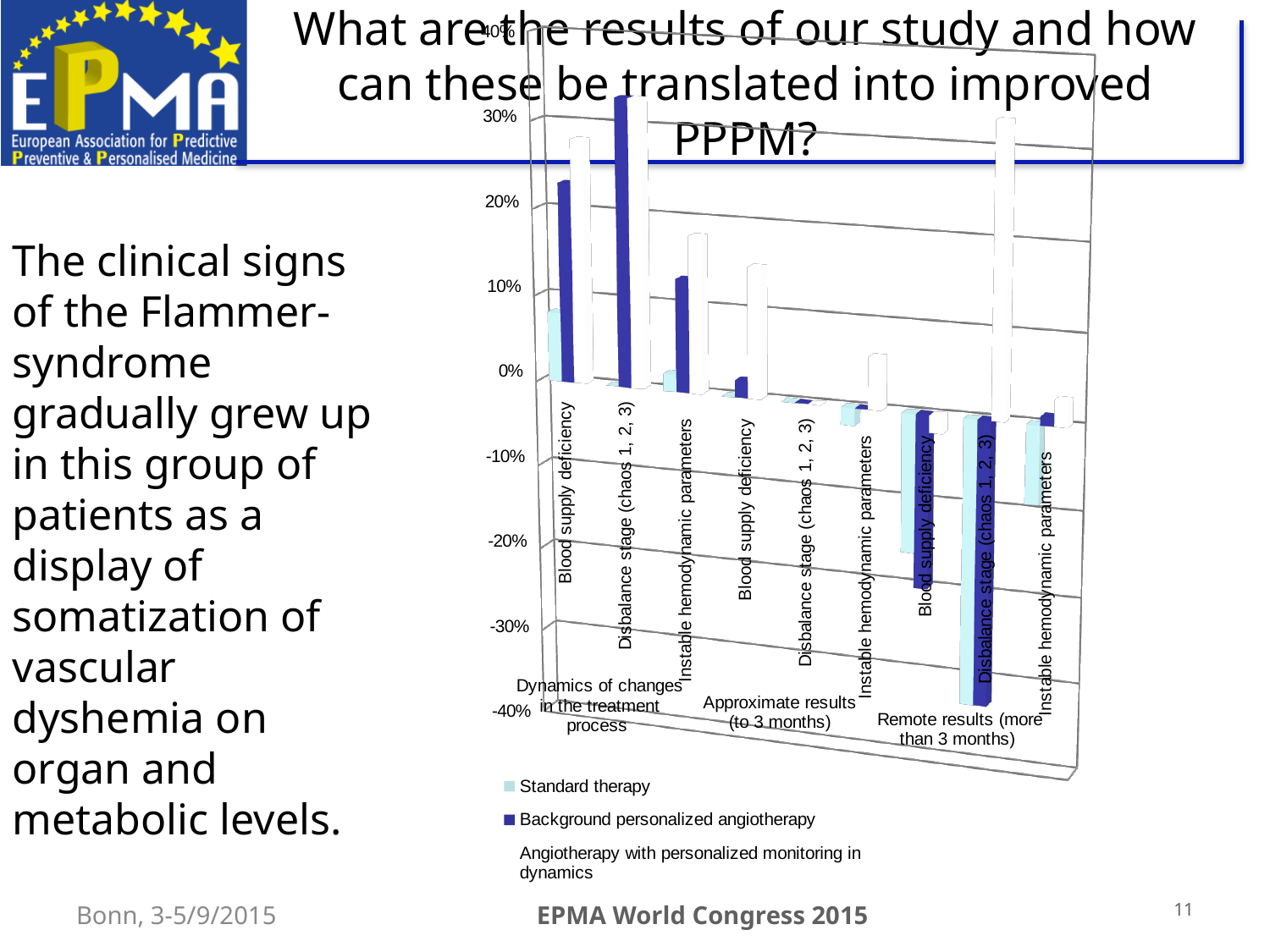
How many result groups are labelled along the x axis of the chart? 3 Do the Background personalized angiotherapy values rise or fall moving from the 'Dynamics of changes in the treatment process' group to the 'Remote results (more than 3 months)' group? fall How many category bars groups (e.g. Blood supply deficiency, Disbalance stage, Instable hemodynamic parameters) are plotted in total across all groups? 9 What kind of chart is shown on the slide? bar chart Is the Background personalized angiotherapy value for Disbalance stage (chaos 1, 2, 3) in the 'Remote results (more than 3 months)' group greater or less than -20%? less How many series does the chart legend list? 3 For the Background personalized angiotherapy series, which category in which group has the highest value? Disbalance stage (chaos 1, 2, 3) in Dynamics of changes in the treatment process Is the Background personalized angiotherapy value for Blood supply deficiency in the 'Dynamics of changes in the treatment process' group greater or less than 10%? greater In the 'Dynamics of changes in the treatment process' group, which has the larger Background personalized angiotherapy value: Blood supply deficiency or Disbalance stage (chaos 1, 2, 3)? Disbalance stage (chaos 1, 2, 3) Is the Background personalized angiotherapy value for Disbalance stage (chaos 1, 2, 3) in the 'Dynamics of changes in the treatment process' group greater or less than 20%? greater Which series is shown in light blue in the legend? Standard therapy What is the name of the third series listed in the legend? Angiotherapy with personalized monitoring in dynamics